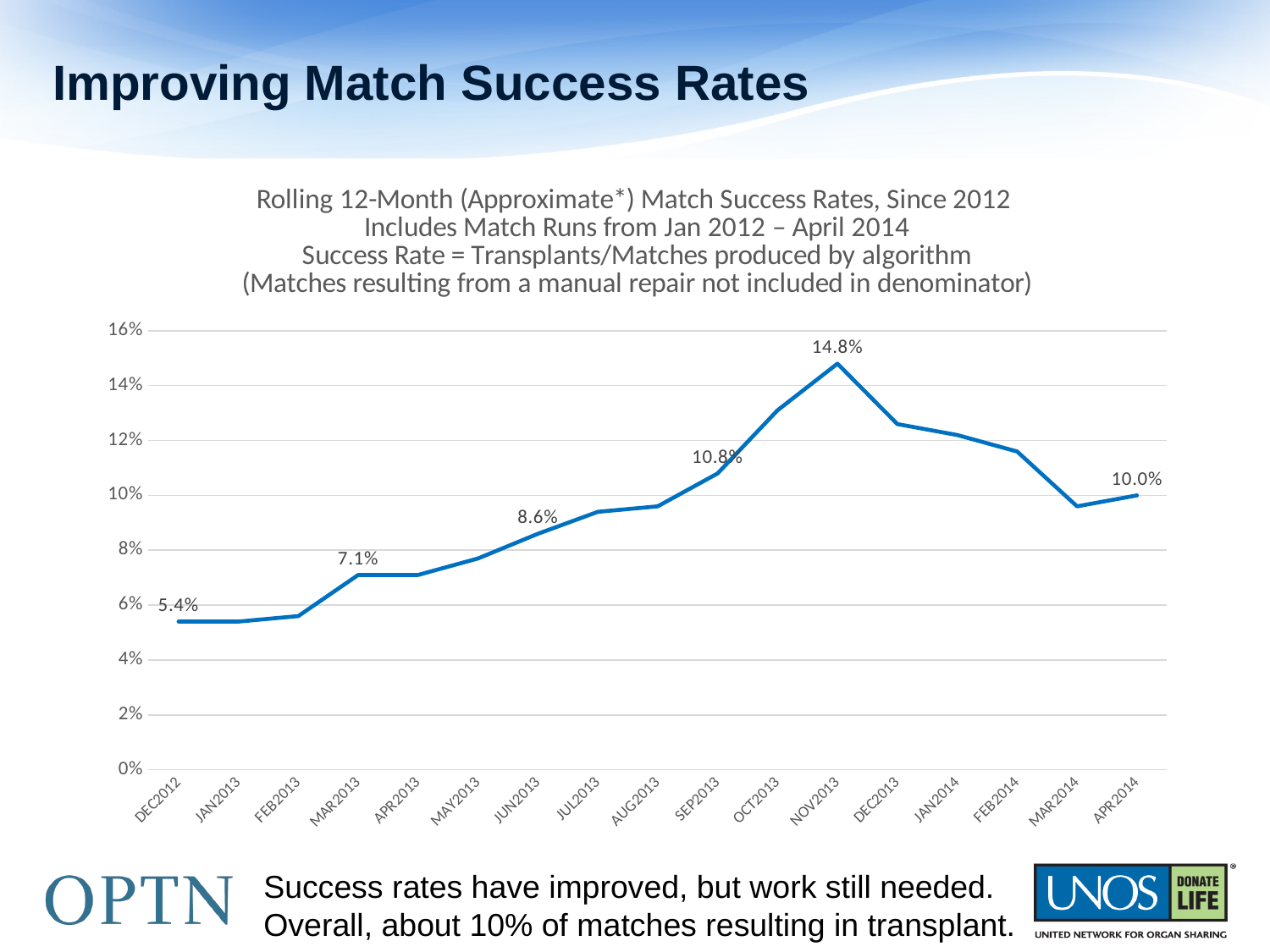
What is the match success rate labeled for NOV2013? 14.8% Which month has the highest match success rate? NOV2013 Is the value for MAR2014 greater or less than 10%? less Is the value for DEC2013 greater or less than 12%? greater What is the match success rate labeled for DEC2012? 5.4% How many months are plotted on the x axis? 17 What is the difference between the SEP2013 rate (10.8%) and the JUN2013 rate (8.6%)? 2.2 percentage points What is the match success rate labeled for APR2014? 10.0% What is the difference between the NOV2013 rate (14.8%) and the DEC2012 rate (5.4%)? 9.4 percentage points What is the match success rate labeled for MAR2013? 7.1% What type of chart is shown on the slide? line chart Which is larger, the rate for SEP2013 or the rate for APR2014? SEP2013